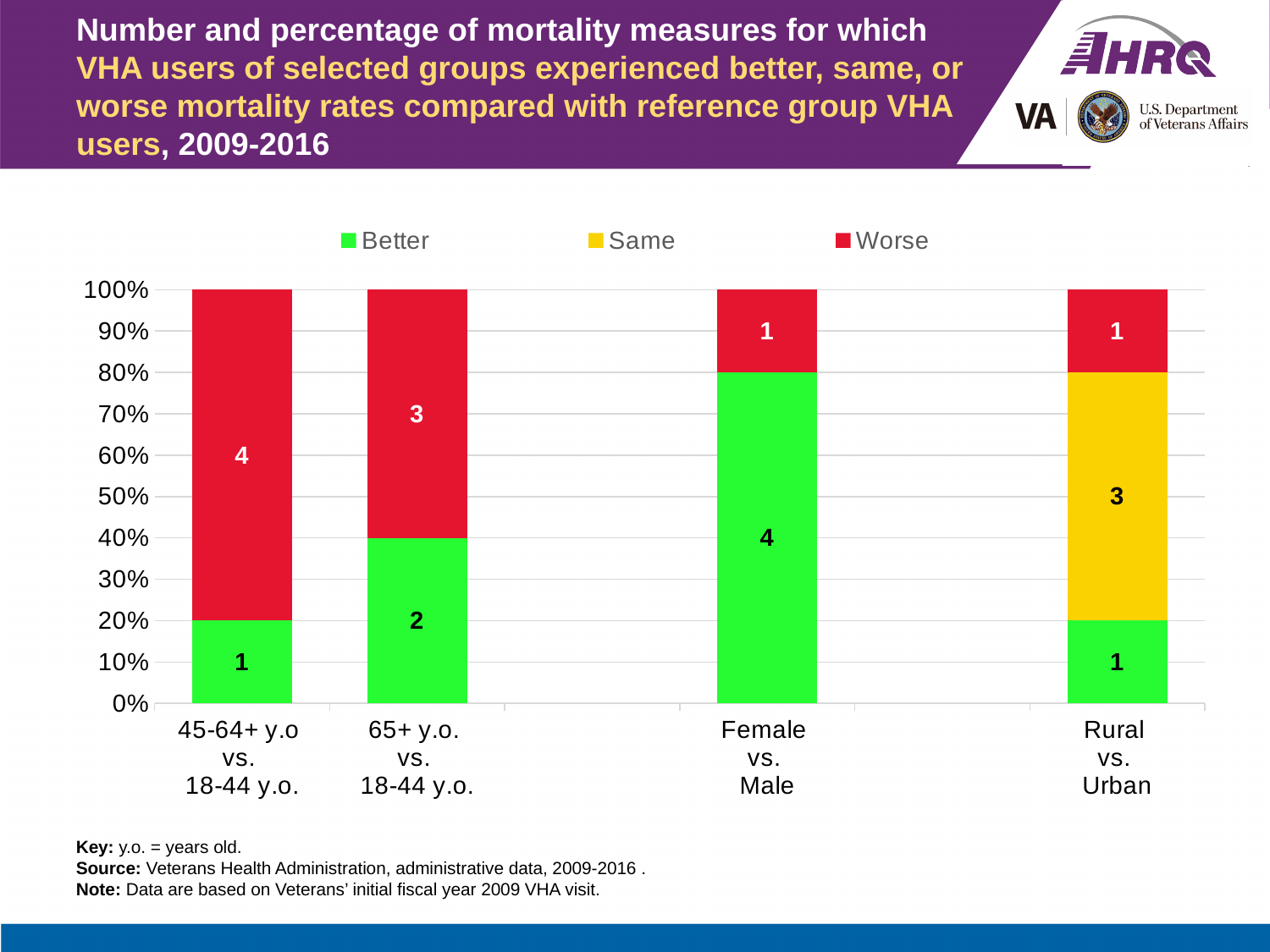
What is the total number of mortality measures in the Rural vs. Urban bar? 5 How many mortality measures were 'Same' for Rural vs. Urban? 3 Which comparison group has the highest number of 'Better' mortality measures? Female vs. Male How many mortality measures were 'Better' for Female vs. Male? 4 How many series does the legend list? 3 Which comparison group has the highest number of 'Worse' mortality measures? 45-64+ y.o vs. 18-44 y.o. What is the difference between the 'Worse' count for 45-64+ y.o vs. 18-44 y.o. and the 'Worse' count for Female vs. Male? 3 How many mortality measures were 'Worse' for 45-64+ y.o vs. 18-44 y.o.? 4 How many comparison groups (categories) are shown on the x axis? 4 How many mortality measures were 'Better' for 65+ y.o. vs. 18-44 y.o.? 2 What kind of chart is shown on the slide? Stacked bar chart Which colour represents the 'Same' series in the legend? Yellow